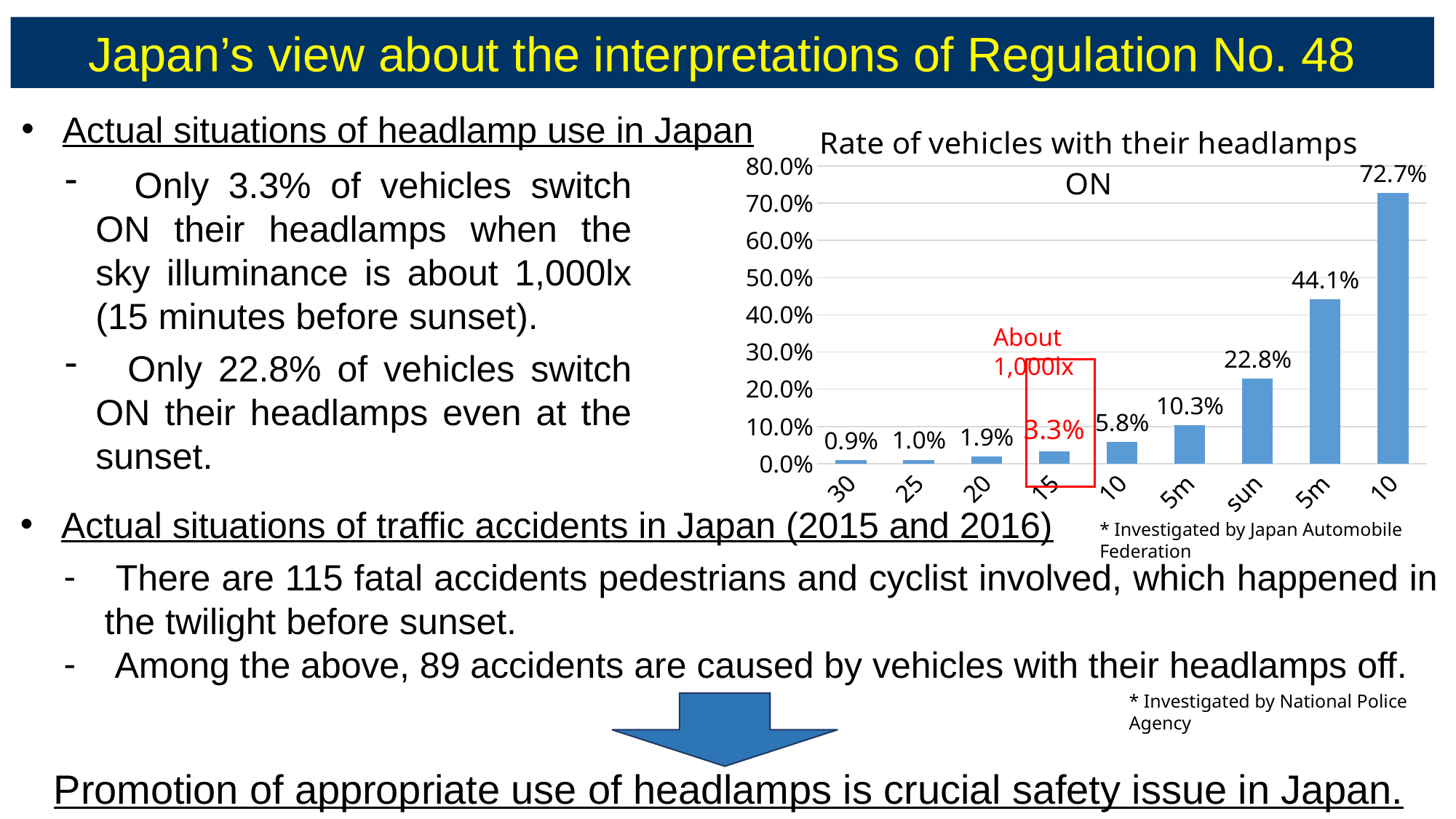
What is the value of the rightmost bar in the chart? 72.7% Which bar has the lowest value in the chart? the leftmost bar (30), 0.9% What is the difference between the rightmost bar (72.7%) and the bar just before it (44.1%)? 28.6% Which bar has the highest value in the chart? the rightmost bar (10), 72.7% How many bars are plotted in the chart? 9 What is the value of the bar labelled "sun"? 22.8% What is the value of the bar labelled "15", highlighted by the red box? 3.3% Is the value of the bar labelled "sun" greater or less than 20.0%? greater Do the values rise or fall from left to right along the x axis? rise What is the value of the first (leftmost) bar in the chart? 0.9% What is the title of the chart? Rate of vehicles with their headlamps ON What kind of chart is shown on the slide? bar chart